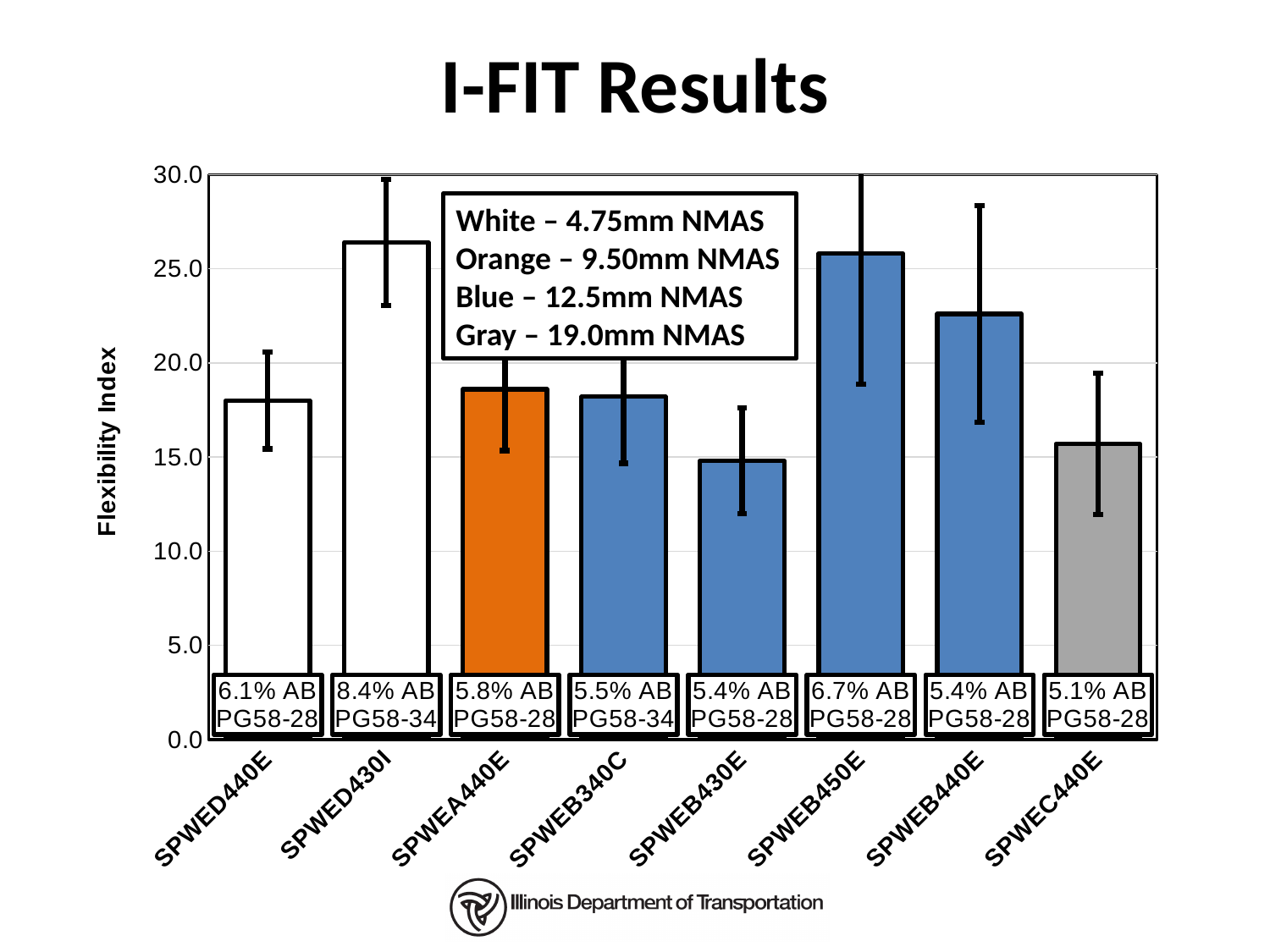
What PG grade is labeled on the SPWEB340C bar? PG58-34 What asphalt binder content is labeled on the SPWED430I bar? 8.4% AB Is the Flexibility Index for SPWED430I greater or less than 25.0? greater Is the Flexibility Index for SPWEB440E greater or less than 20.0? greater Is the Flexibility Index for SPWED440E greater or less than 20.0? less Which has the higher Flexibility Index, SPWEB440E or SPWEC440E? SPWEB440E Which has the higher Flexibility Index, SPWED430I or SPWEB430E? SPWED430I According to the legend box, what NMAS do the orange bars represent? 9.50mm NMAS What kind of chart is shown on the slide? bar chart How many mix categories are plotted on the x axis? 8